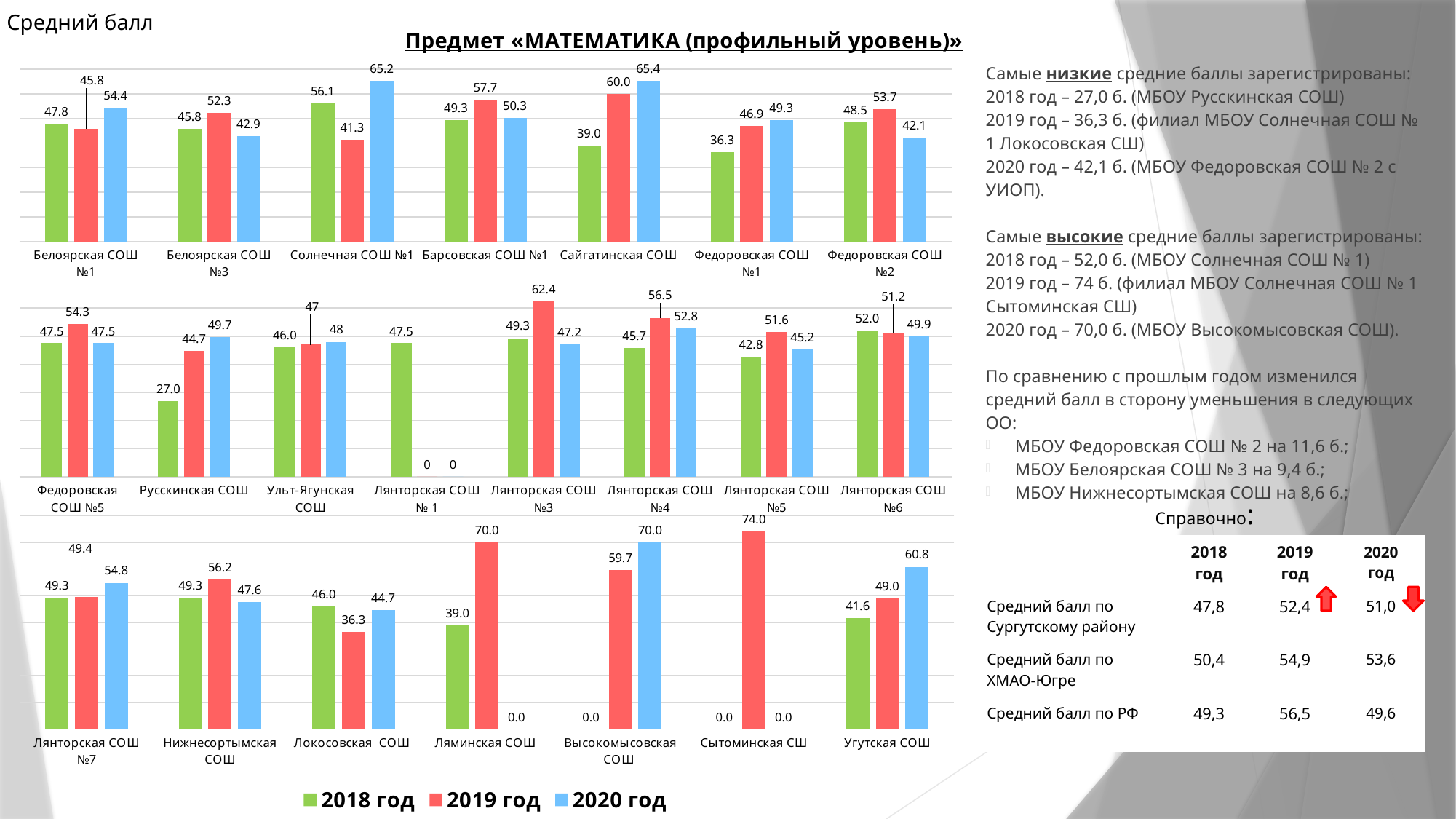
Which colour represents 2018 год in the legend? Green In the top chart, which is larger for Федоровская СОШ №2: the 2019 год value or the 2020 год value? 2019 год In the middle chart, which school has the lowest 2018 год value? Русскинская СОШ In the bottom chart, what is the 2019 год value for Сытоминская СШ? 74.0 In the top chart, what is the 2019 год value for Солнечная СОШ №1? 41.3 In the middle chart, which school has the highest 2019 год value? Лянторская СОШ №3 What kind of chart is used on this slide? Bar chart In the top chart, what is the 2020 год value for Сайгатинская СОШ? 65.4 How many series does the legend list? 3 In the middle chart, what is the 2020 год value for Лянторская СОШ №1? 0 In the bottom chart, what is the difference between the 2020 год and 2018 год values for Угутская СОШ? 19.2 How many schools are shown in the bottom chart? 7